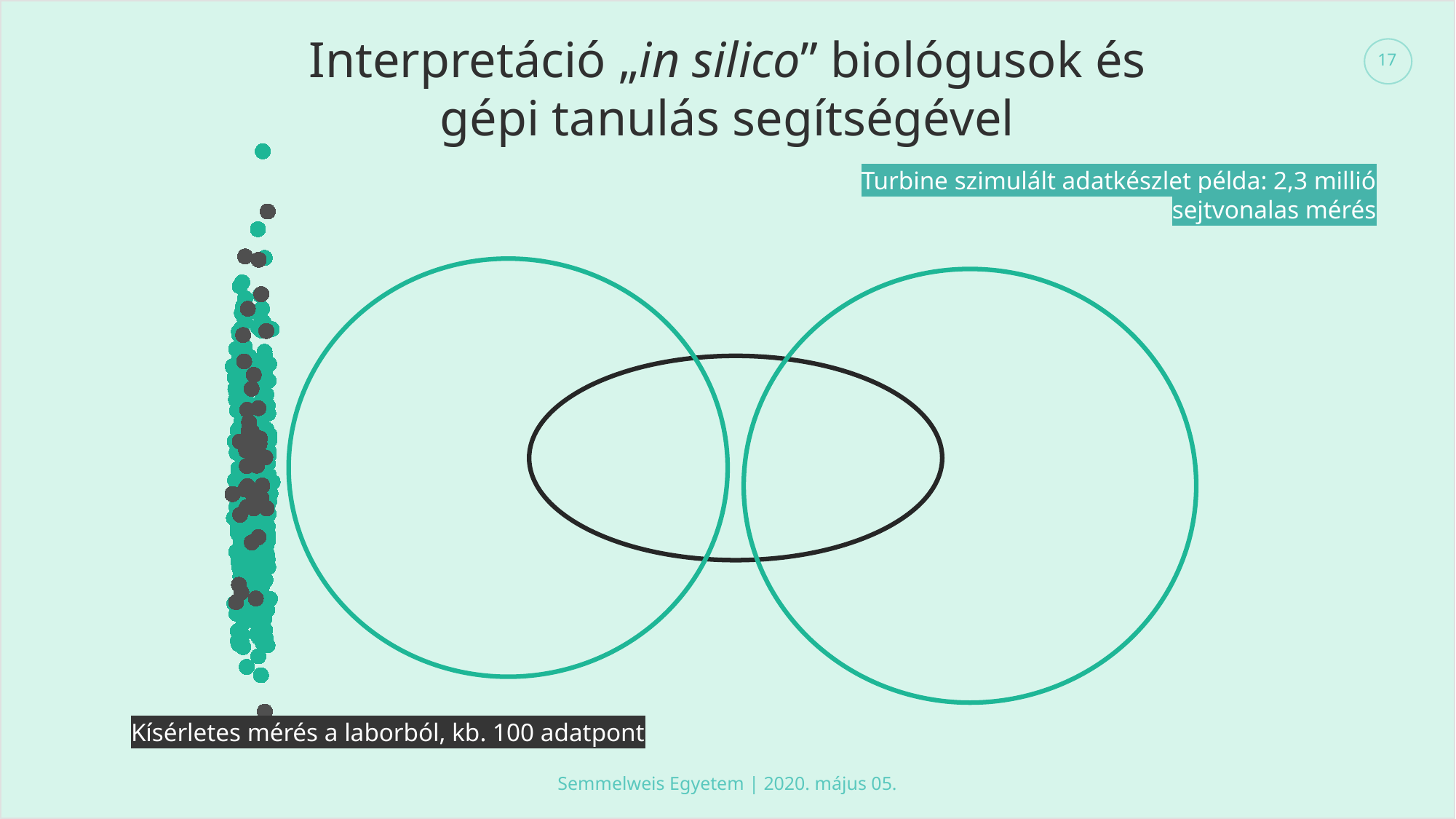
In the scatter chart on the left, are there more green points or more dark grey points? green What kind of chart is shown on the left side of the slide? scatter chart According to the label under the scatter chart, roughly how many data points does the experimental lab measurement contain? kb. 100 adatpont How many different point colours are used in the scatter chart on the left? 2